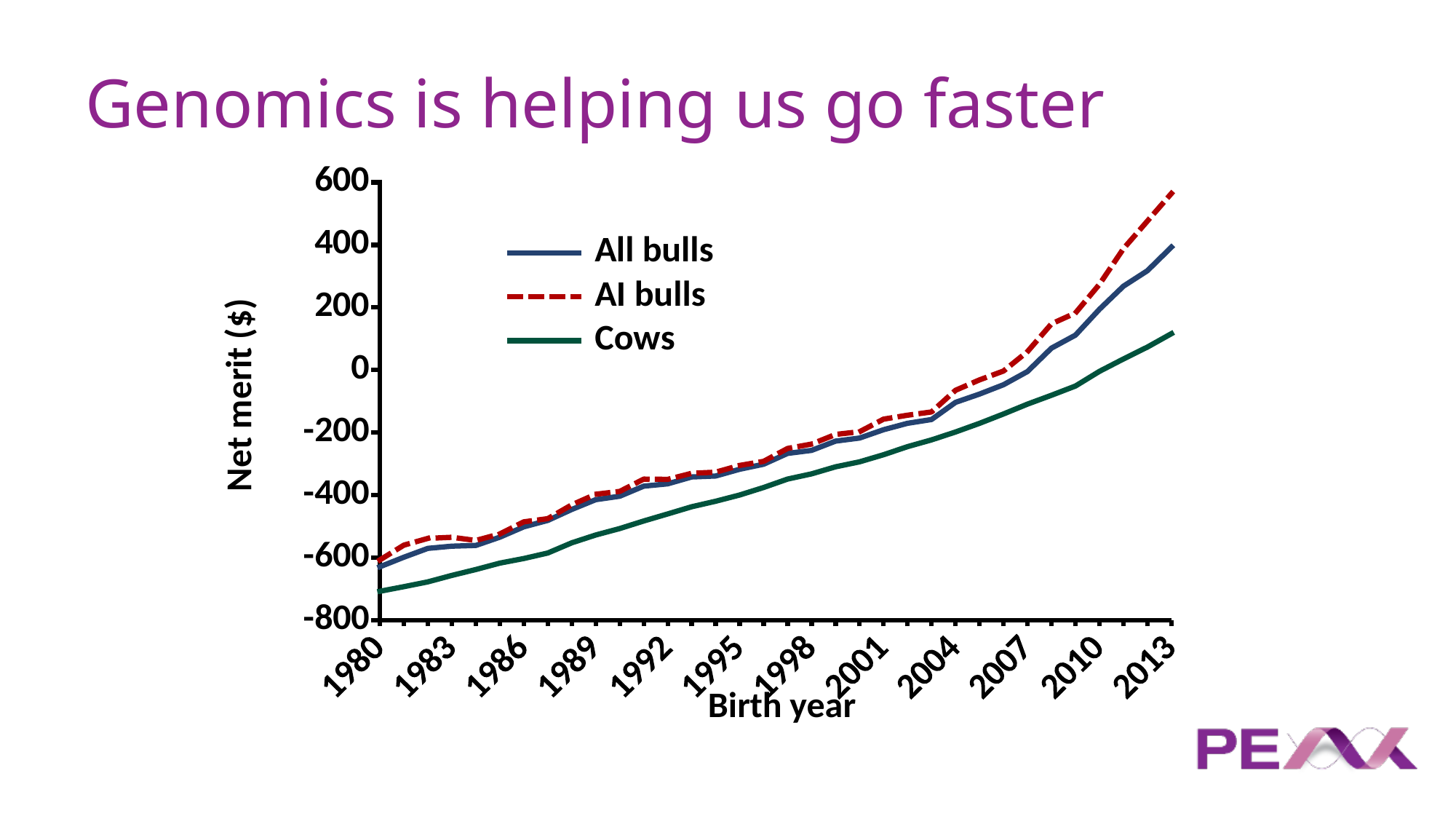
Is the value for AI bulls at 1995 greater or less than -200? less Do the values for Cows rise or fall from 1980 to 2013? rise How many series does the legend list? 3 At 1980, which is larger: the value for All bulls or the value for Cows? All bulls Is the value for Cows at 1980 greater or less than -600? less Which series has the lowest value at 2013? Cows Which series is plotted with a dashed red line? AI bulls Which series has the highest value at 2013? AI bulls What is the label of the y axis? Net merit ($) Is the value for AI bulls at 2013 greater or less than 400? greater What kind of chart is shown on the slide? line chart